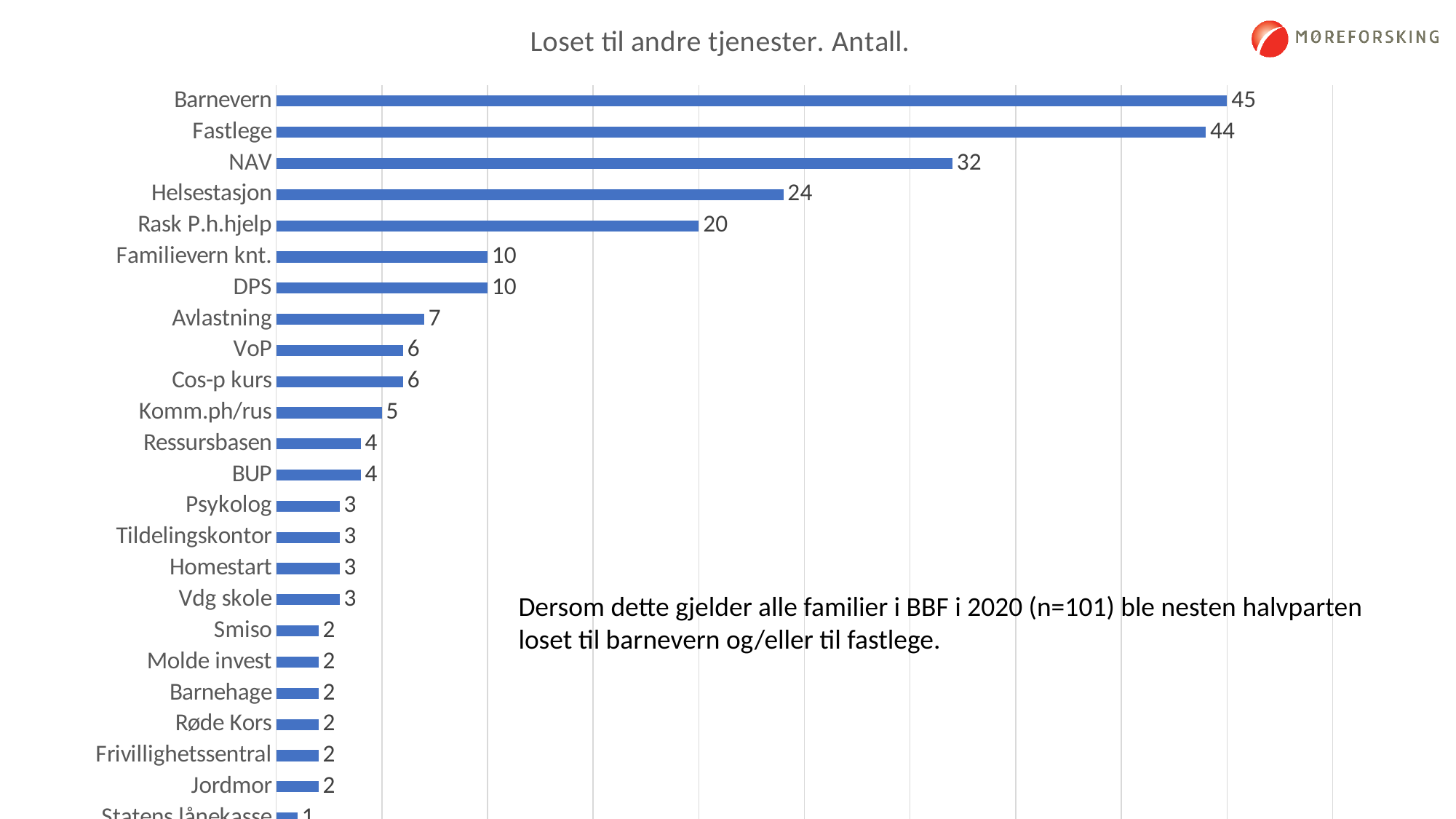
What type of chart is shown on the slide? bar chart What is the value for Rask P.h.hjelp? 20 What is the value for NAV? 32 What is the value for Helsestasjon? 24 What is the difference between the values for NAV and Helsestasjon? 8 What is the title of the chart? Loset til andre tjenester. Antall. What is the difference between the values for Barnevern and Fastlege? 1 What is the value for Avlastning? 7 What is the value for Barnevern? 45 Which is larger, the value for Komm.ph/rus or the value for Ressursbasen? Komm.ph/rus Which category has the highest value? Barnevern Which is larger, the value for Rask P.h.hjelp or the value for DPS? Rask P.h.hjelp